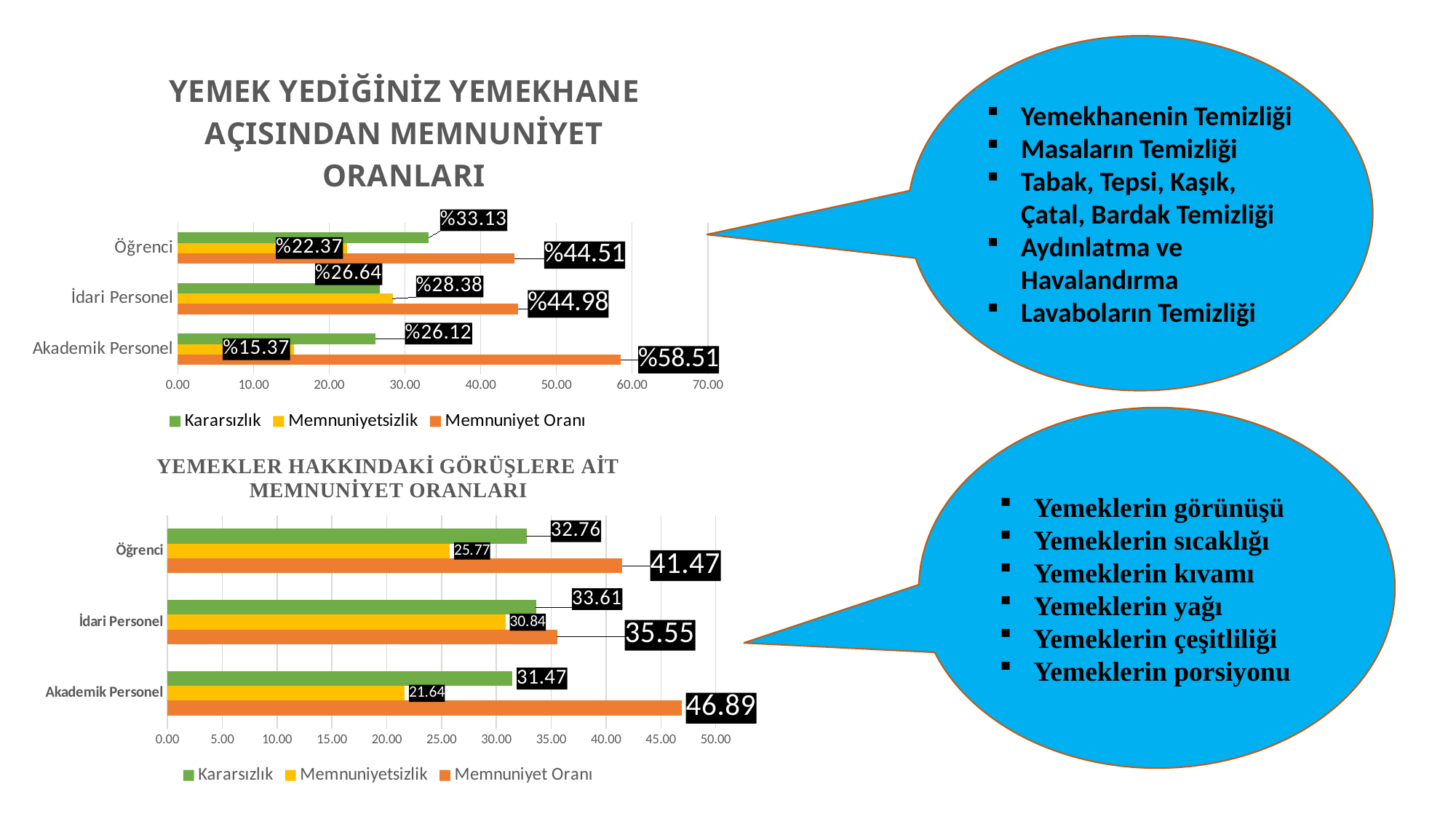
In the top chart, which category has the highest Memnuniyet Oranı? Akademik Personel In the bottom chart, which category has the highest Memnuniyet Oranı? Akademik Personel In the bottom chart, is the Memnuniyetsizlik value for İdari Personel larger or smaller than that for Öğrenci? larger What type of chart is the bottom chart? Bar chart In the top chart, how many series does the legend list? 3 In the bottom chart, how many categories are shown on the vertical axis? 3 In the top chart, which category has the lowest Memnuniyetsizlik value? Akademik Personel In the top chart, what is the difference between the Memnuniyet Oranı values for Akademik Personel and Öğrenci? 14.00 In the top chart (YEMEK YEDİĞİNİZ YEMEKHANE AÇISINDAN MEMNUNİYET ORANLARI), what is the Memnuniyet Oranı value for Akademik Personel? %58.51 In the bottom chart, what is the Kararsızlık value for Akademik Personel? 31.47 In the bottom chart (YEMEKLER HAKKINDAKİ GÖRÜŞLERE AİT MEMNUNİYET ORANLARI), what is the Memnuniyet Oranı value for İdari Personel? 35.55 In the top chart, what is the Memnuniyetsizlik value for Öğrenci? %22.37